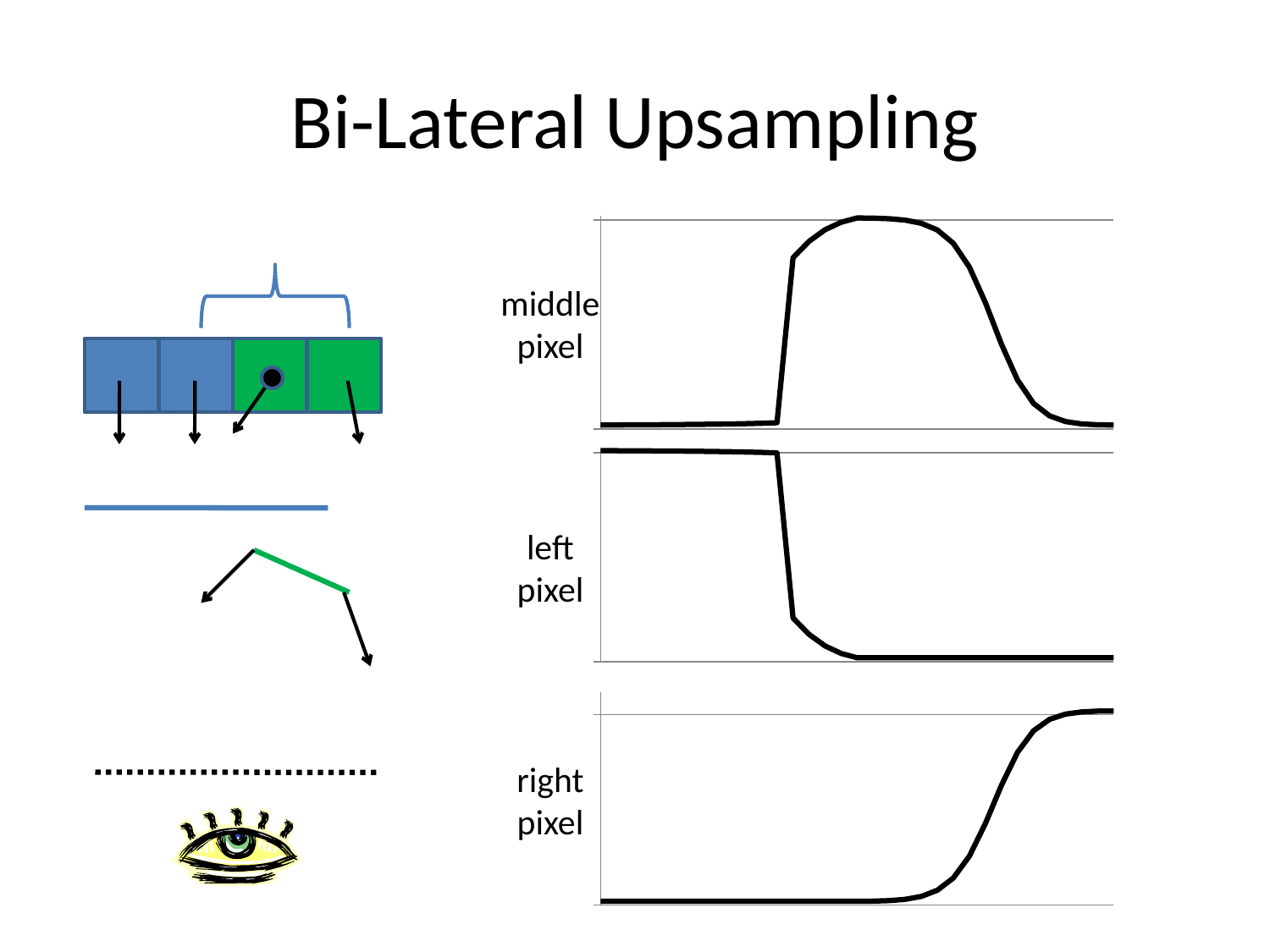
In the 'middle pixel' chart, does the line rise or fall in its left half? rise In the 'middle pixel' chart, does the line rise or fall in its right half? fall In the 'right pixel' chart, is the value at the left end higher or lower than the value at the right end? lower How many lines are plotted in the 'right pixel' chart? 1 What is the label of the top chart on the slide? middle pixel In the 'left pixel' chart, is the value at the left end higher or lower than the value at the right end? higher What is the label of the bottom chart on the slide? right pixel What kind of chart is the 'middle pixel' chart? line chart How many charts are shown on the slide? 3 In the 'right pixel' chart, does the line rise or fall from left to right? rise